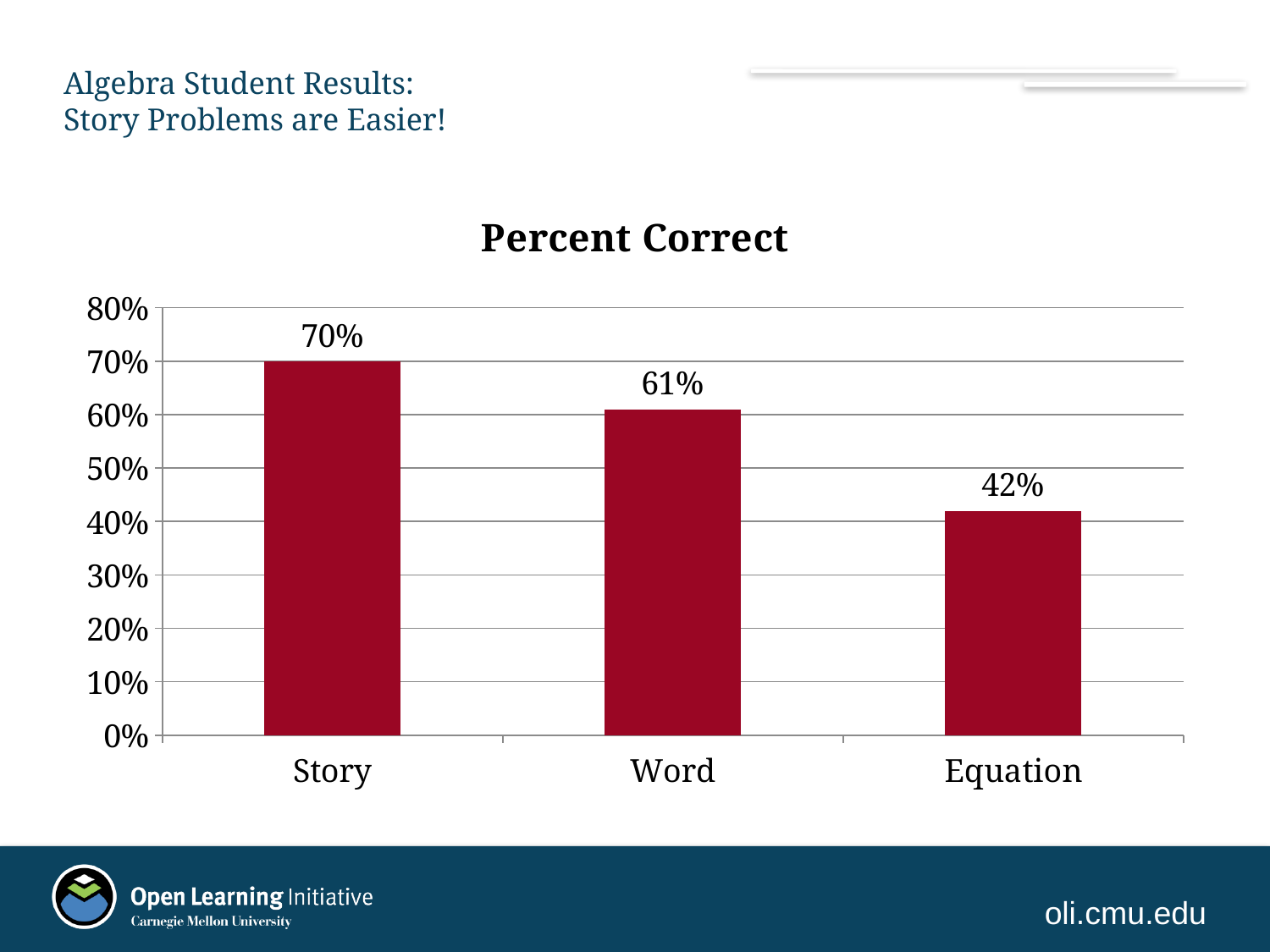
What is the percent correct for Word problems? 61% What is the difference in percent correct between Story and Word? 9% What is the difference in percent correct between Story and Equation? 28% Is the value for Equation greater or less than 50%? less How many categories are shown in the chart? 3 What is the title of the chart? Percent Correct Which has a higher percent correct, Word or Equation? Word What is the percent correct for Story problems? 70% What is the percent correct for Equation problems? 42% Which category has the lowest percent correct? Equation What kind of chart is shown on the slide? Bar chart Which category has the highest percent correct? Story